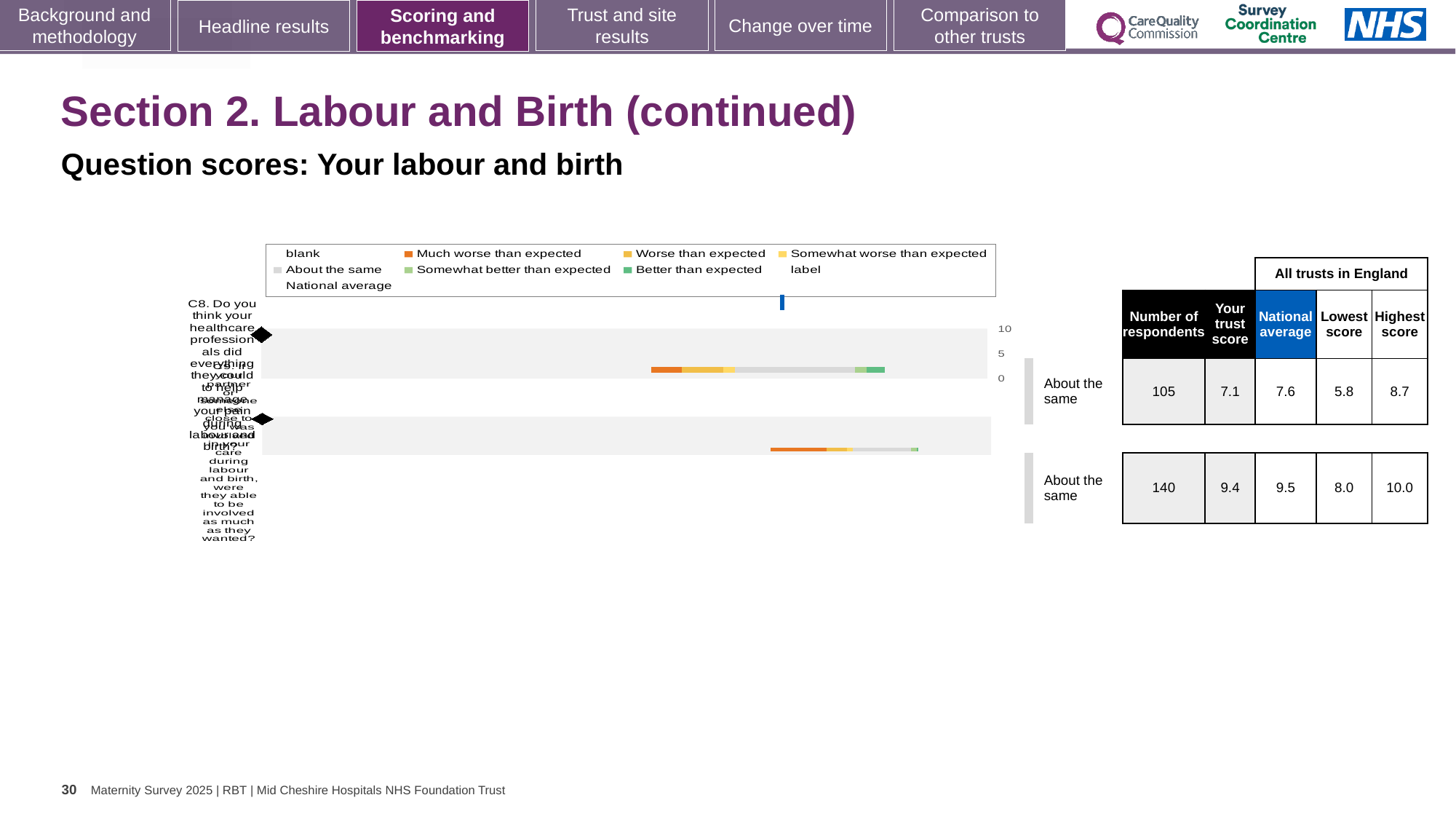
How many question bars are plotted in the chart? 2 In the table beside the chart, which is larger for question C8 (the first row): the trust score or the national average? National average In the table beside the chart, what is the difference between the national average and the trust score for the second row? 0.1 What kind of chart is shown on the slide? bar chart In the table beside the chart, what is the number of respondents for question C8 (the first row)? 105 In the table beside the chart, what is the trust score for question C8 (the first row)? 7.1 In the chart legend, what colour represents 'Much worse than expected'? orange In the chart legend, what colour represents 'Better than expected'? green In the table beside the chart, what is the number of respondents for the second row? 140 In the table beside the chart, what is the highest score among all trusts in England for the second row? 10.0 In the table beside the chart, what is the difference between the highest score and the lowest score for question C8 (the first row)? 2.9 In the table beside the chart, what is the national average for question C8 (the first row)? 7.6